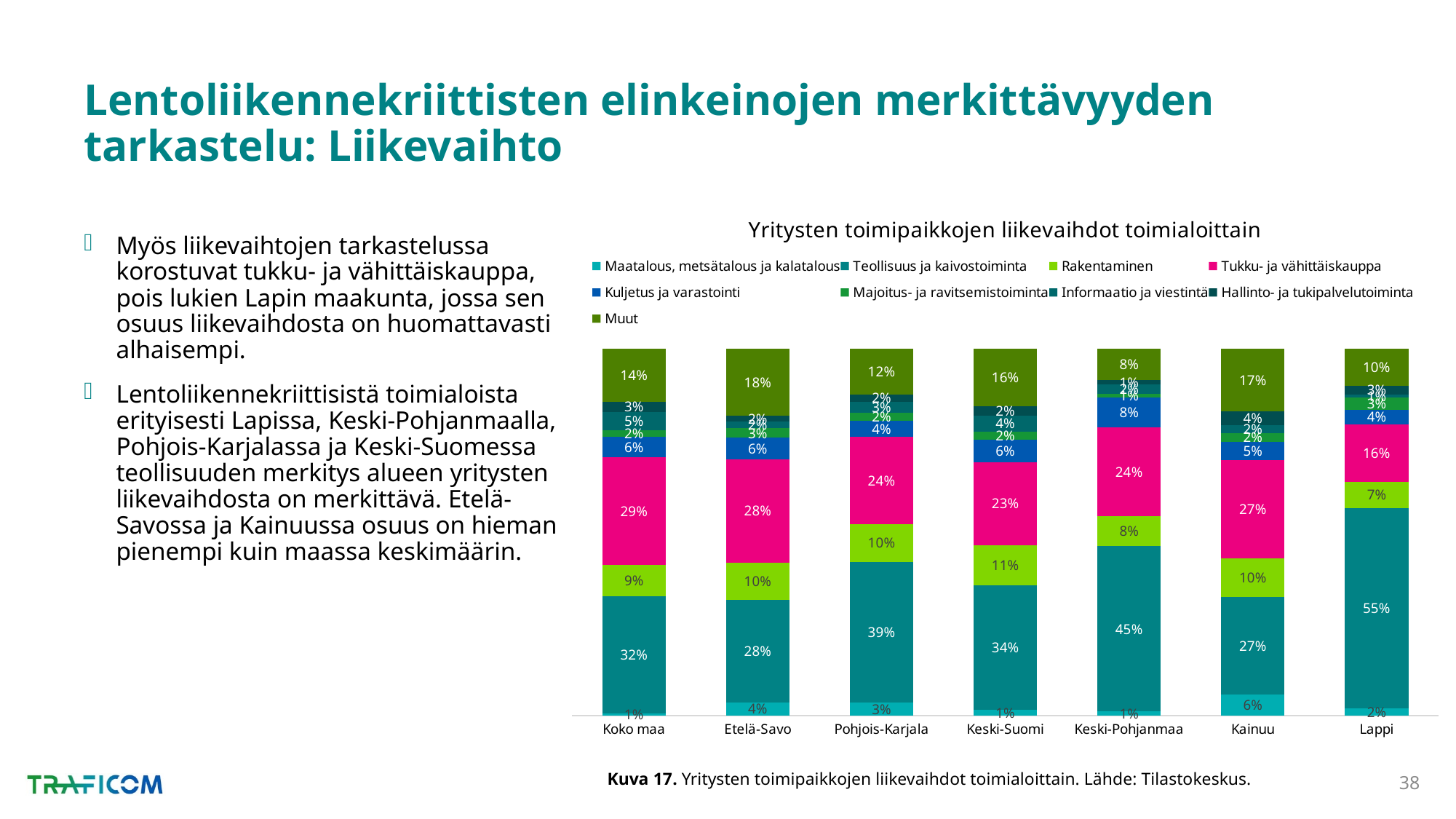
Which is larger: the Rakentaminen share in Keski-Suomi or in Kainuu? Keski-Suomi What is the difference between the Teollisuus ja kaivostoiminta share in Lappi and in Koko maa? 23 percentage points What is the value for Kuljetus ja varastointi in Keski-Pohjanmaa? 8% What kind of chart is shown on the slide? Stacked bar chart What is the value for Tukku- ja vähittäiskauppa in Koko maa? 29% Which region has the highest share for Maatalous, metsätalous ja kalatalous? Kainuu Which region has the highest share for Muut? Etelä-Savo Which region has the highest share for Teollisuus ja kaivostoiminta? Lappi Which region has the lowest share for Tukku- ja vähittäiskauppa? Lappi How many regions (bars) are shown in the chart? 7 How many series does the legend list? 9 What is the value for Teollisuus ja kaivostoiminta in Lappi? 55%